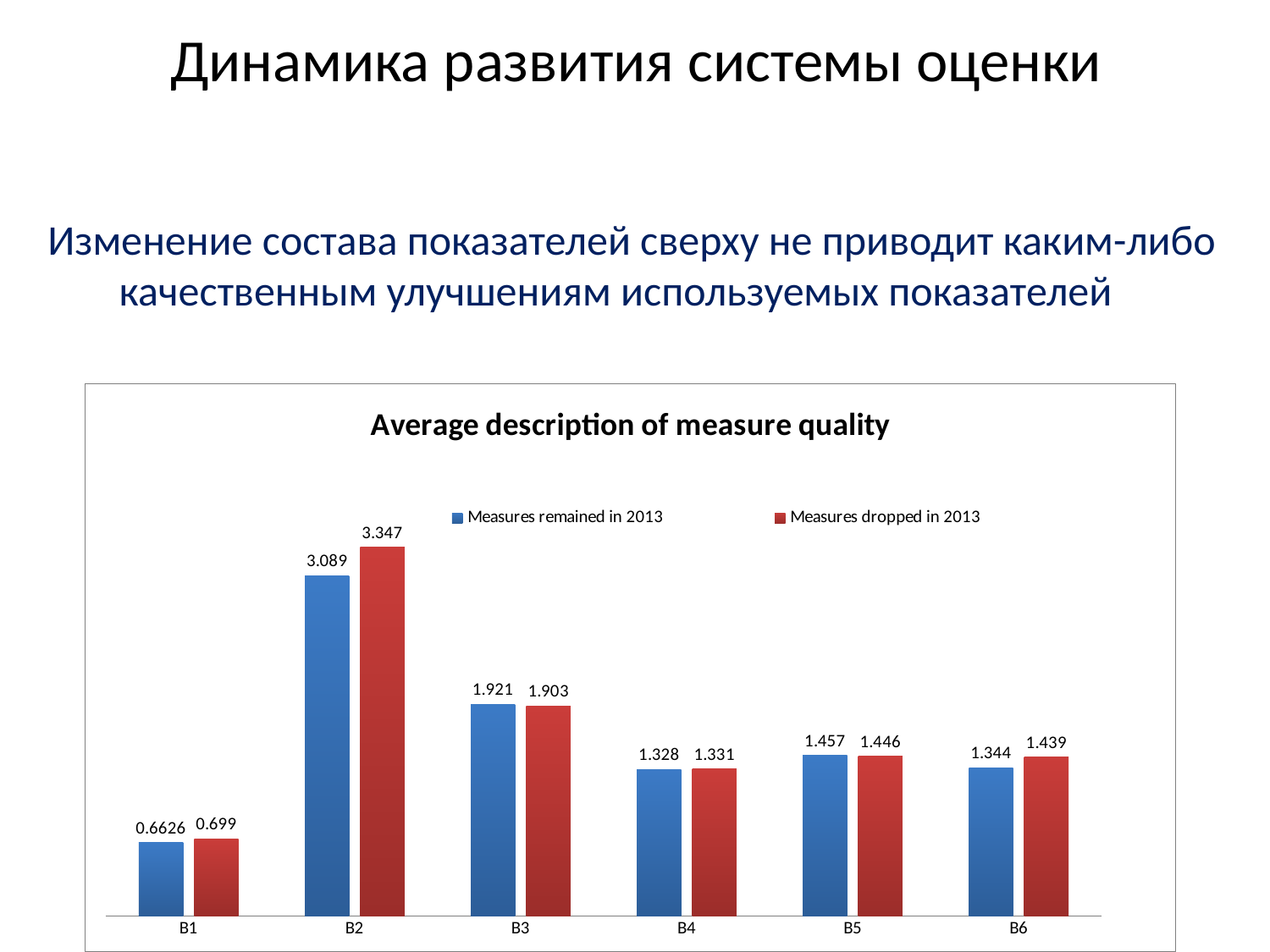
For B6, which series has the larger value: 'Measures remained in 2013' or 'Measures dropped in 2013'? Measures dropped in 2013 What is the difference between the 'Measures dropped in 2013' and 'Measures remained in 2013' values for B2? 0.258 What is the value for B5 in the 'Measures remained in 2013' series? 1.457 What is the value for B1 in the 'Measures dropped in 2013' series? 0.699 How many categories are shown on the x axis of the chart? 6 What is the value for B2 in the 'Measures remained in 2013' series? 3.089 How many series does the chart legend list? 2 What is the title of the chart? Average description of measure quality Which category has the highest value in the 'Measures dropped in 2013' series? B2 What type of chart is shown on the slide? bar chart Which colour represents the 'Measures remained in 2013' series? blue Which category has the lowest value in the 'Measures remained in 2013' series? B1